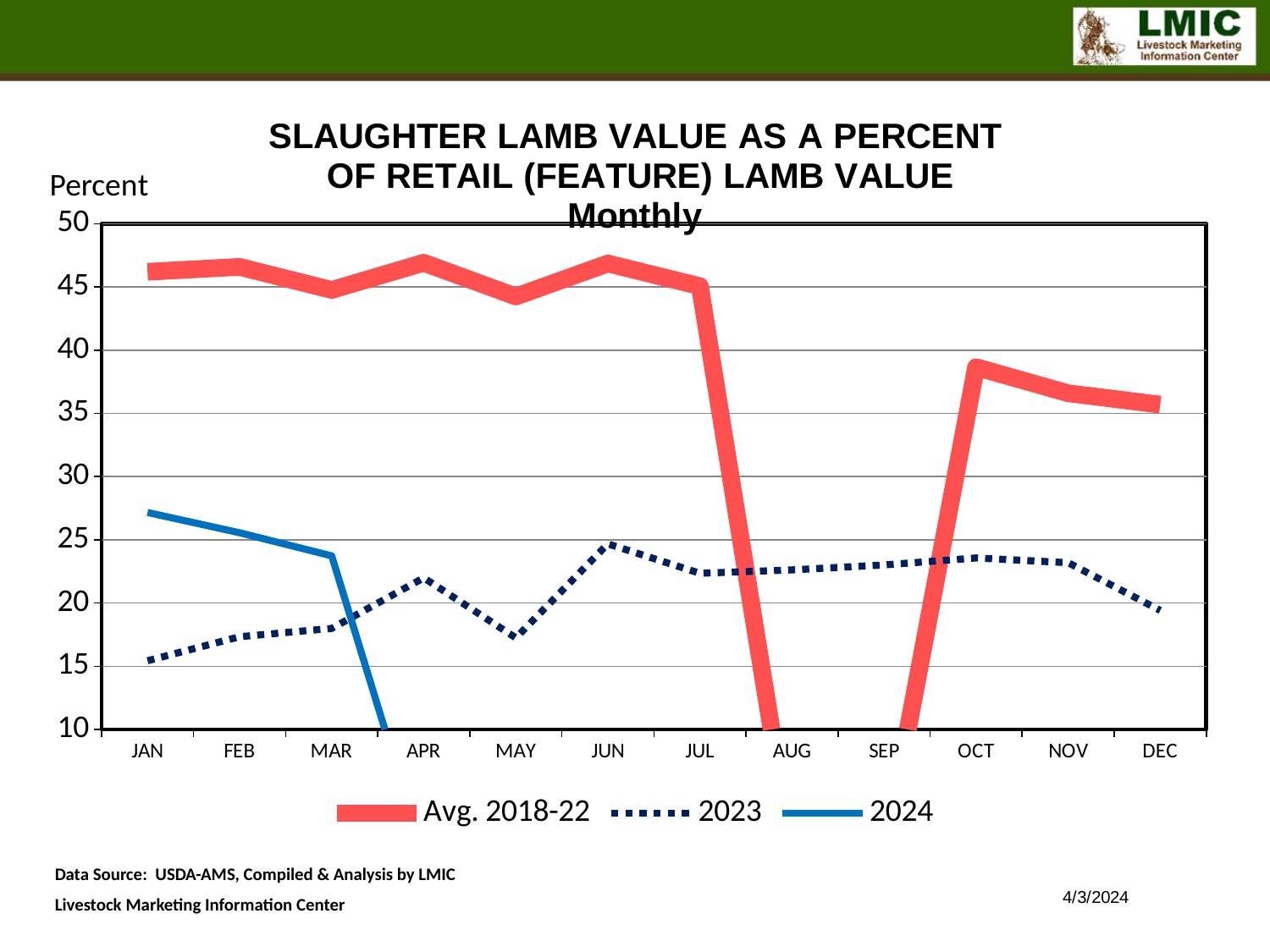
How many months are shown along the x axis? 12 Is the Avg. 2018-22 value for OCT greater or less than 35? greater In which month is the 2023 series at its lowest value? JAN Is the 2023 value for JAN greater or less than 20? less Is the 2023 value for JUN greater or less than 20? greater In JAN, which series has the higher value, 2023 or 2024? 2024 What kind of chart is shown on the slide? line chart How many series does the legend list? 3 Does the 2024 line rise or fall from JAN to MAR? fall What label is shown on the vertical axis of the chart? Percent